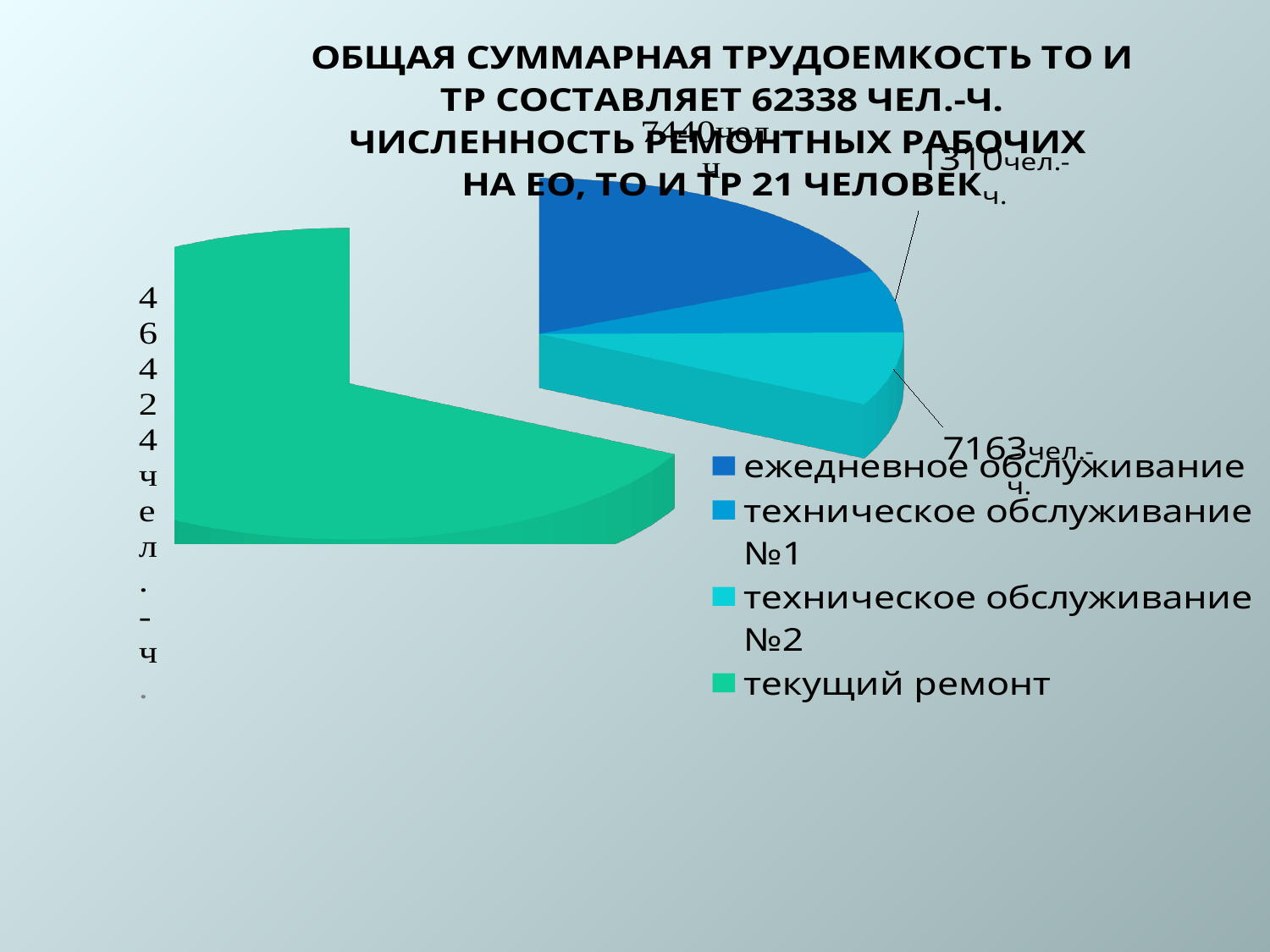
What is the value for текущий ремонт? 46424 чел.-ч. How many slices does the pie chart have? 4 Which category has the smallest slice of the pie? техническое обслуживание №1 What is the value for техническое обслуживание №1? 1310 чел.-ч. How many entries does the legend list? 4 Which colour represents текущий ремонт in the legend? green What kind of chart is shown on the slide? pie chart Which category has the largest slice of the pie? текущий ремонт What is the difference between the values for техническое обслуживание №2 and техническое обслуживание №1? 5853 чел.-ч. What is the value for ежедневное обслуживание? 7440 чел.-ч. Which is larger, техническое обслуживание №1 or техническое обслуживание №2? техническое обслуживание №2 What is the value for техническое обслуживание №2? 7163 чел.-ч.